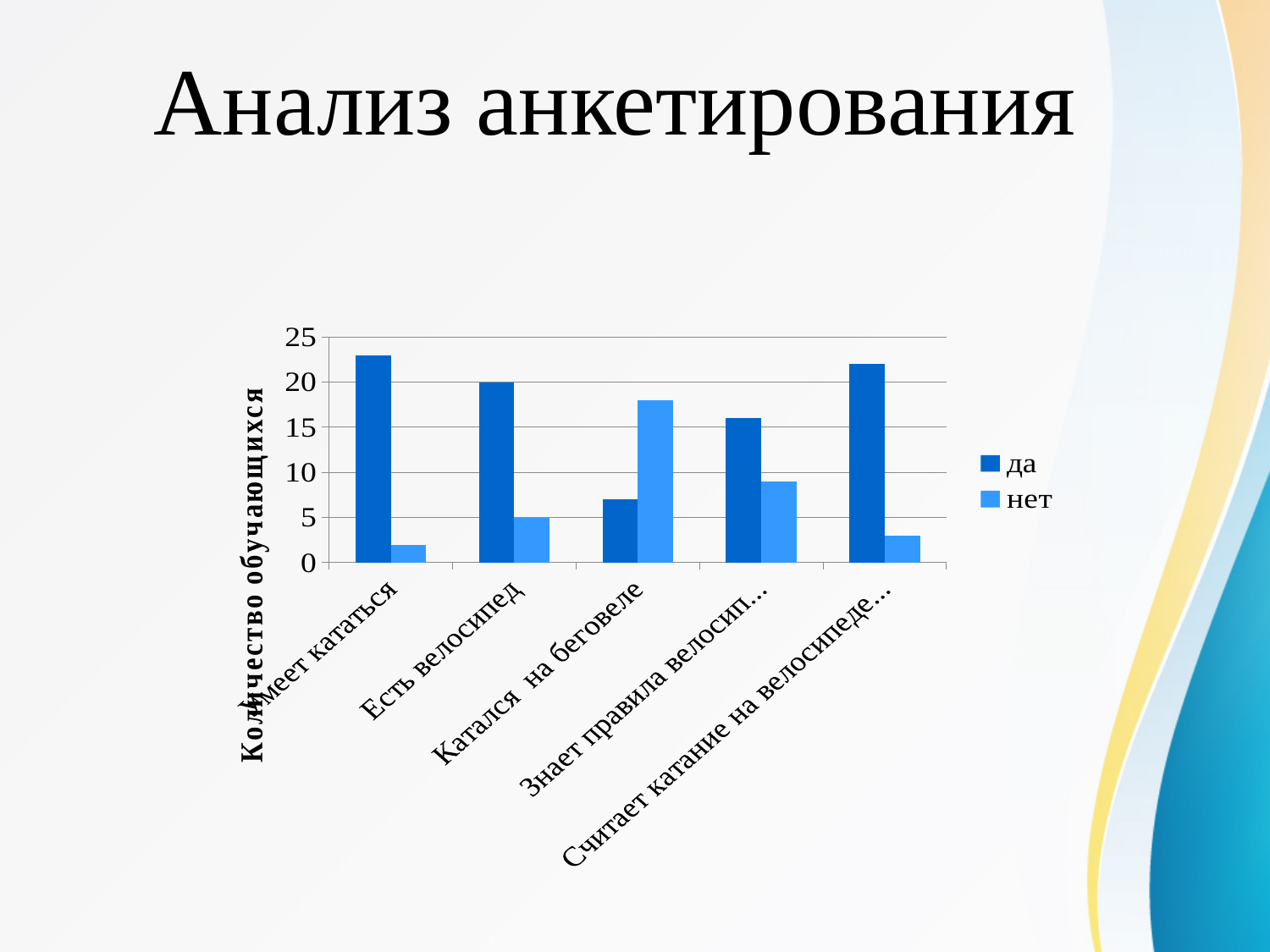
What is the title of the vertical axis? Количество обучающихся What is the value of the 'да' bar for 'Есть велосипед'? 20 For 'Катался на беговеле', which is larger: the 'да' bar or the 'нет' bar? нет What are the two series named in the legend? да and нет How many series does the chart's legend list? 2 Is the 'нет' value for 'Катался на беговеле' greater or less than 15? greater How many categories are shown on the x axis of the chart? 5 What is the value of the 'нет' bar for 'Есть велосипед'? 5 What kind of chart is shown on the slide? bar chart Which category has the highest 'нет' value? Катался на беговеле Which category has the lowest 'да' value? Катался на беговеле Is the 'да' value for 'Умеет кататься' greater or less than 20? greater